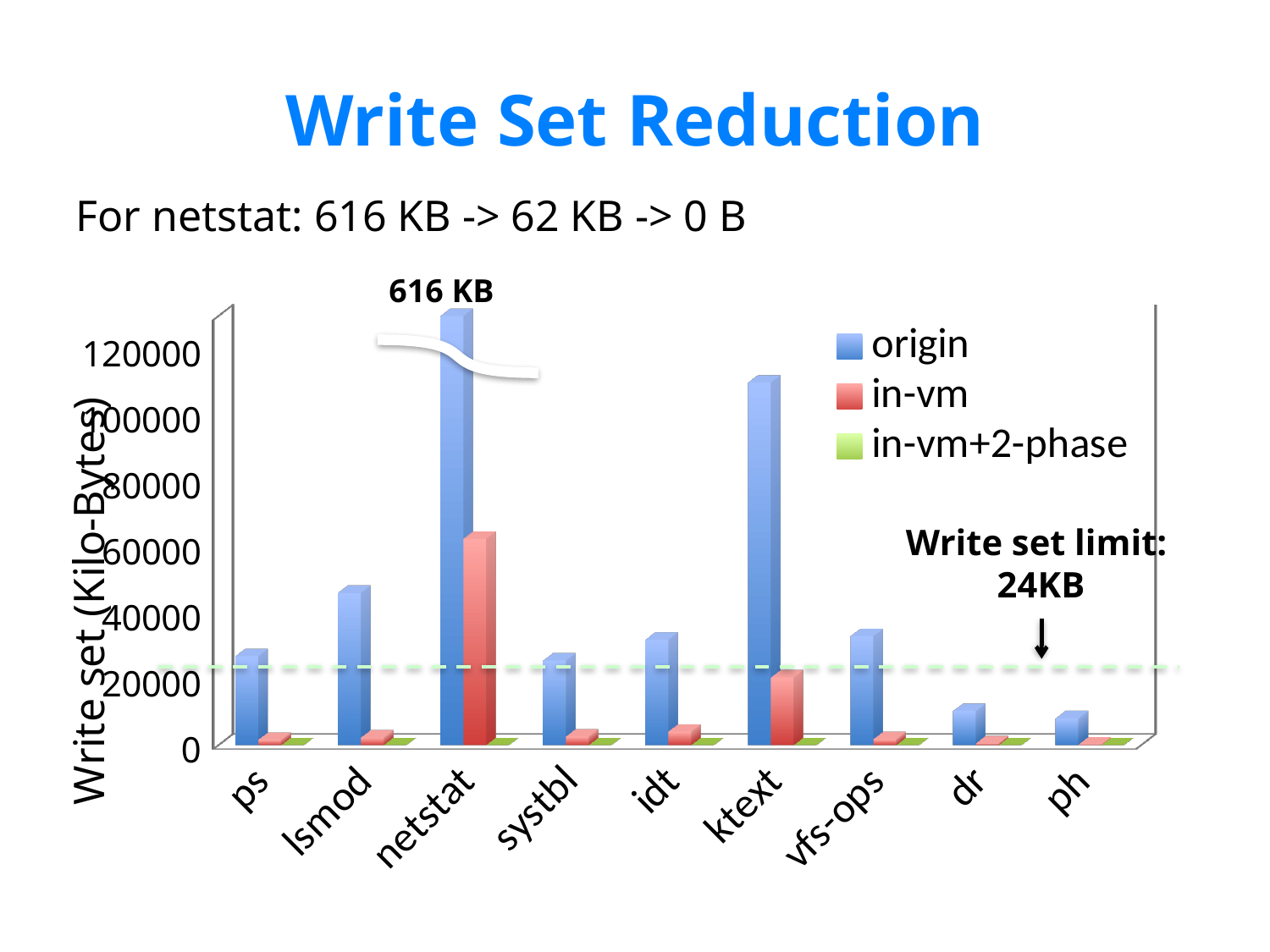
Is the origin value for lsmod greater or less than 40000? greater What value is labelled on the origin bar for netstat? 616 KB What is the title of the chart slide? Write Set Reduction How many series does the legend list? 3 Is the origin value for dr greater or less than 20000? less What kind of chart is shown on the slide? bar chart Which category has the highest origin value? netstat Which category has the highest in-vm value? netstat What write set limit is marked by the dashed line on the chart? 24KB Which is larger, the origin value for ktext or the origin value for lsmod? ktext Is the origin value for ktext greater or less than 100000? greater How many categories are shown on the x axis? 9